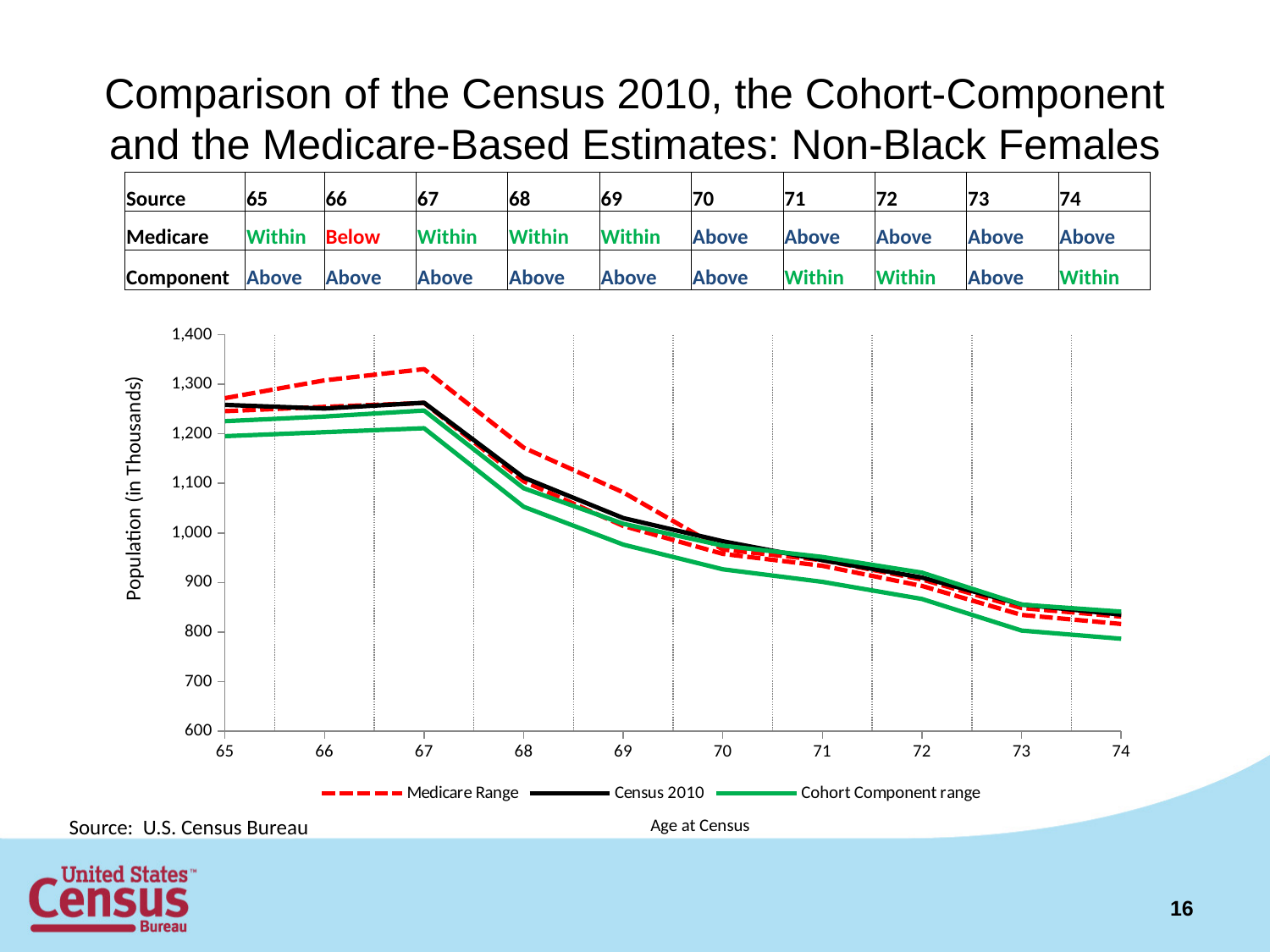
Is the Census 2010 value at age 73 greater or less than 900? less Which series is drawn as a red dashed line in the chart? Medicare Range Which is larger for Census 2010: the value at age 68 or the value at age 70? age 68 Is the Census 2010 value at age 69 greater or less than 1,000? greater At which age does the Census 2010 line reach its lowest value? 74 Is the Census 2010 value at age 65 greater or less than 1,200? greater What is the label of the y axis of the chart? Population (in Thousands) Does the Census 2010 line rise or fall as age increases from 67 to 74? fall What kind of chart is shown on the slide? line chart How many series does the chart legend list? 3 How many ages are plotted along the x axis of the chart? 10